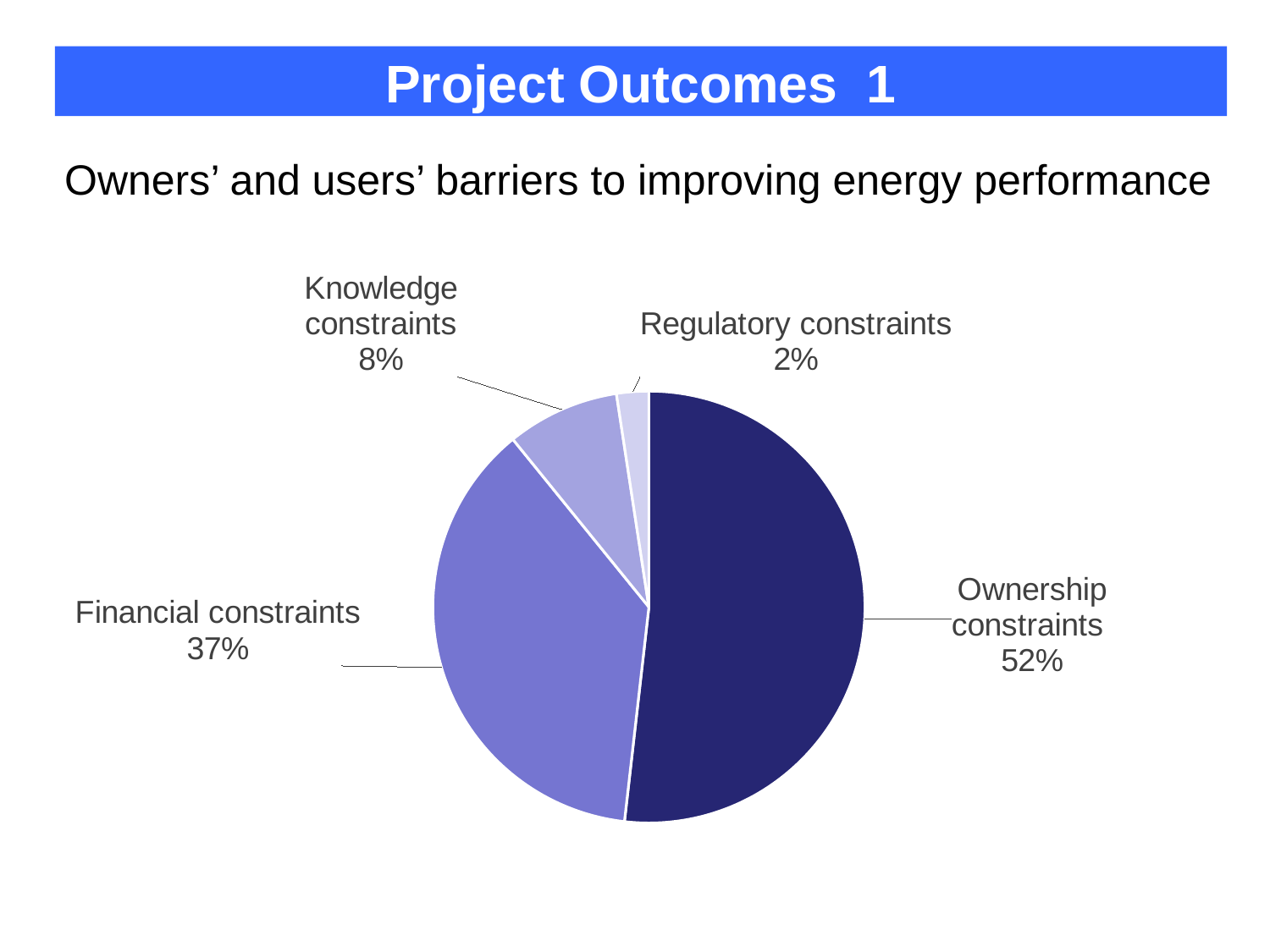
Which is larger, Financial constraints or Knowledge constraints? Financial constraints What is the subtitle describing the chart on the slide? Owners' and users' barriers to improving energy performance How many categories are shown in the pie chart? 4 What share of the pie is Knowledge constraints? 8% Which category has the largest slice of the pie? Ownership constraints What kind of chart is shown on the slide? Pie chart Which category has the smallest slice of the pie? Regulatory constraints What share of the pie is Regulatory constraints? 2% What share of the pie is Ownership constraints? 52% What is the difference in percentage points between Knowledge constraints and Regulatory constraints? 6 What is the difference in percentage points between Ownership constraints and Financial constraints? 15